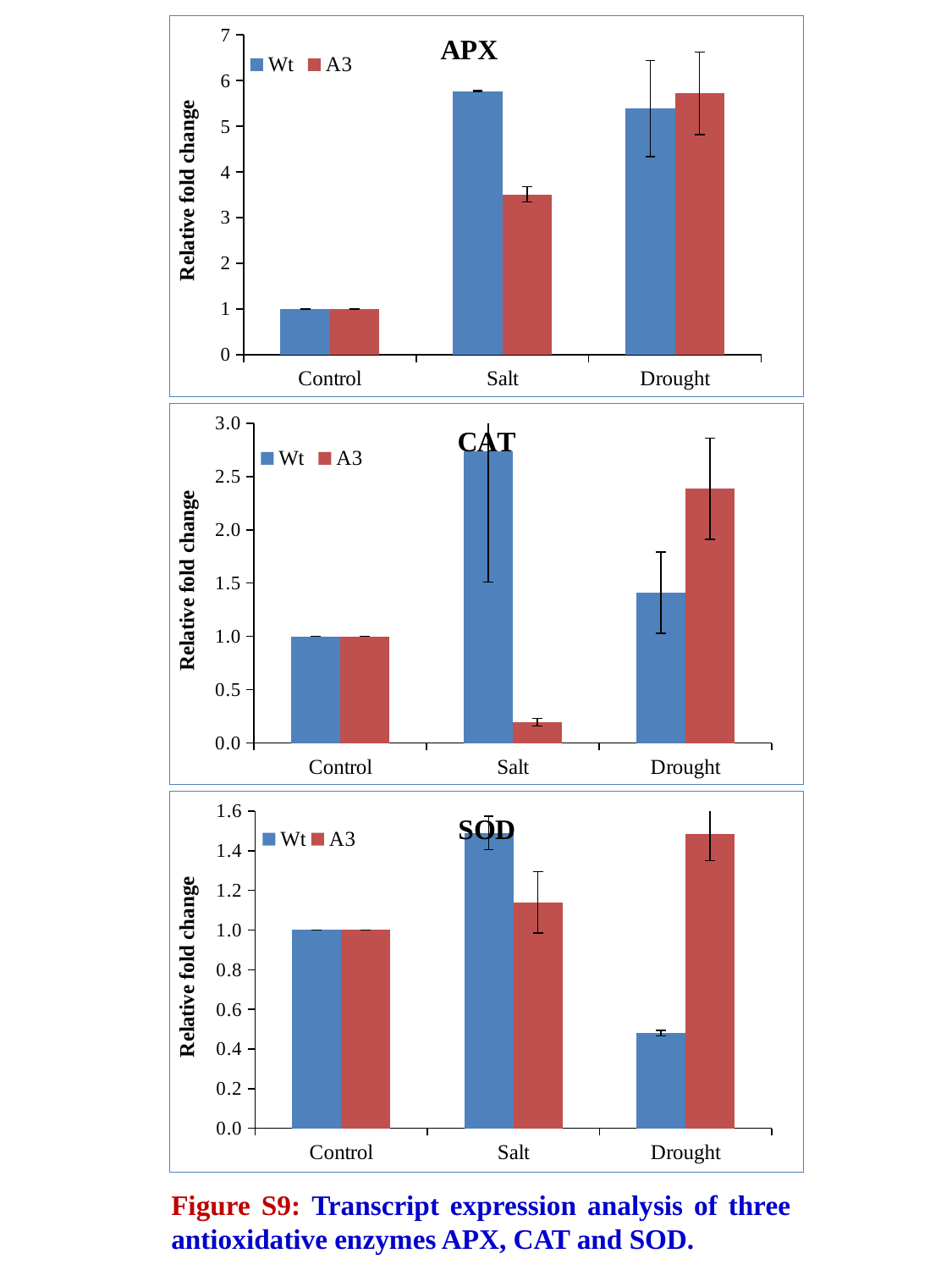
In the APX chart, what is the relative fold change for Wt under Control? 1 What kind of chart is the APX chart? bar chart In the APX chart, which is larger under Salt, Wt or A3? Wt In the CAT chart, which category has the lowest A3 value? Salt In the CAT chart, is the value for Wt under Salt greater or less than 2.5? greater How many series does the legend of the CAT chart list? 2 In the SOD chart, is the value for Wt under Drought greater or less than 0.6? less In the CAT chart, which is larger under Drought, Wt or A3? A3 How many categories are shown on the x axis of the SOD chart? 3 In the APX chart, is the value for A3 under Salt greater or less than 4? less In the SOD chart, what is the relative fold change for A3 under Control? 1.0 In the SOD chart, which category has the lowest Wt value? Drought